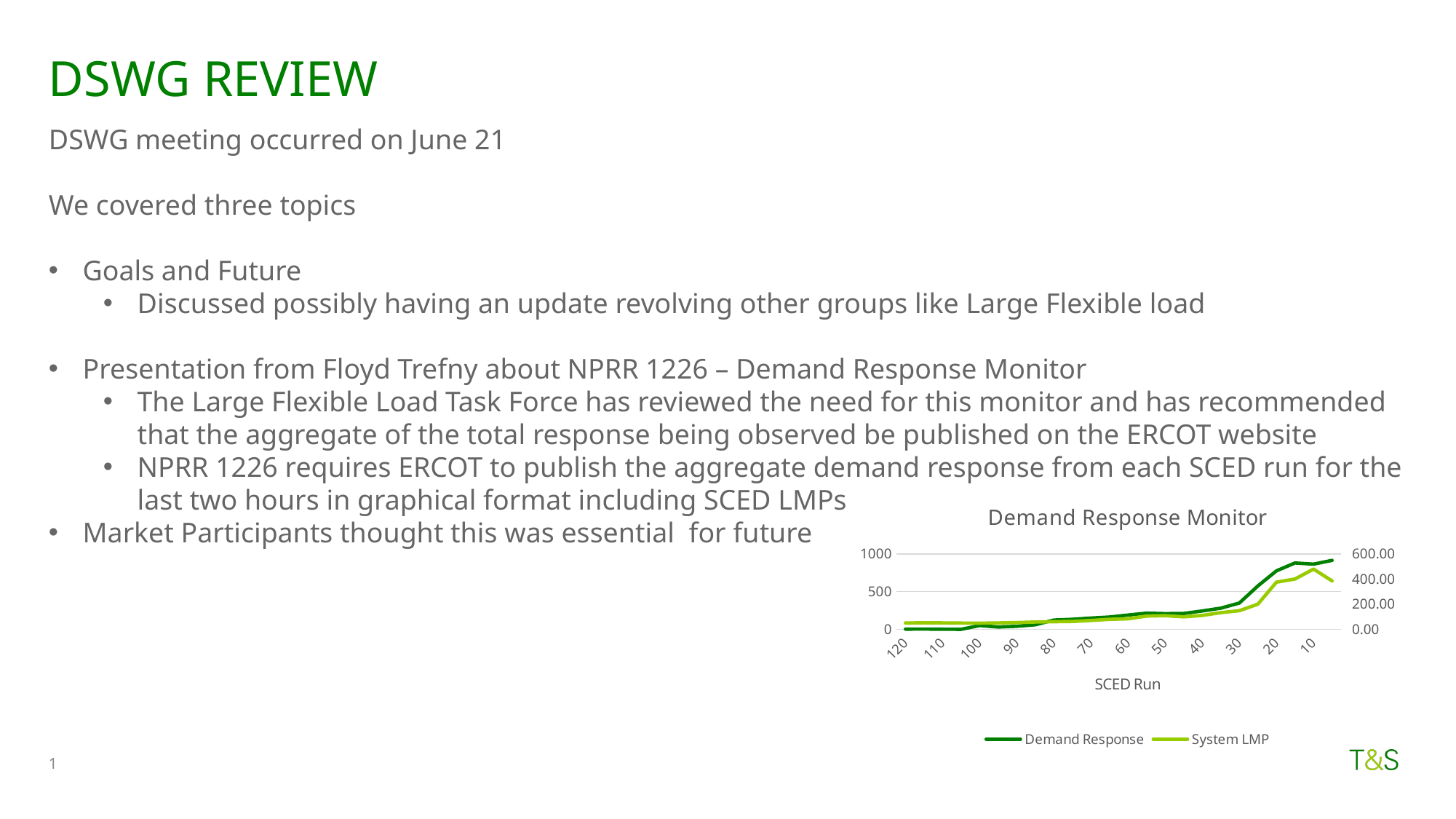
In the Demand Response Monitor chart, is the Demand Response value at SCED Run 60 greater or less than 500 on the left axis? less How many series does the legend of the Demand Response Monitor chart list? 2 What is the highest value shown on the left vertical axis of the Demand Response Monitor chart? 1000 In the Demand Response Monitor chart, is the Demand Response value at SCED Run 10 greater or less than 500 on the left axis? greater What kind of chart is the Demand Response Monitor chart? line chart In the Demand Response Monitor chart, do the System LMP values generally rise or fall moving from SCED Run 120 toward SCED Run 10? rise What is the x-axis title of the Demand Response Monitor chart? SCED Run What is the highest value shown on the right vertical axis of the Demand Response Monitor chart? 600.00 In the Demand Response Monitor chart, is the Demand Response value at SCED Run 120 greater or less than 500 on the left axis? less In the Demand Response Monitor chart, do the Demand Response values rise or fall moving from left to right along the x axis? rise How many labelled tick marks are on the x axis of the Demand Response Monitor chart? 12